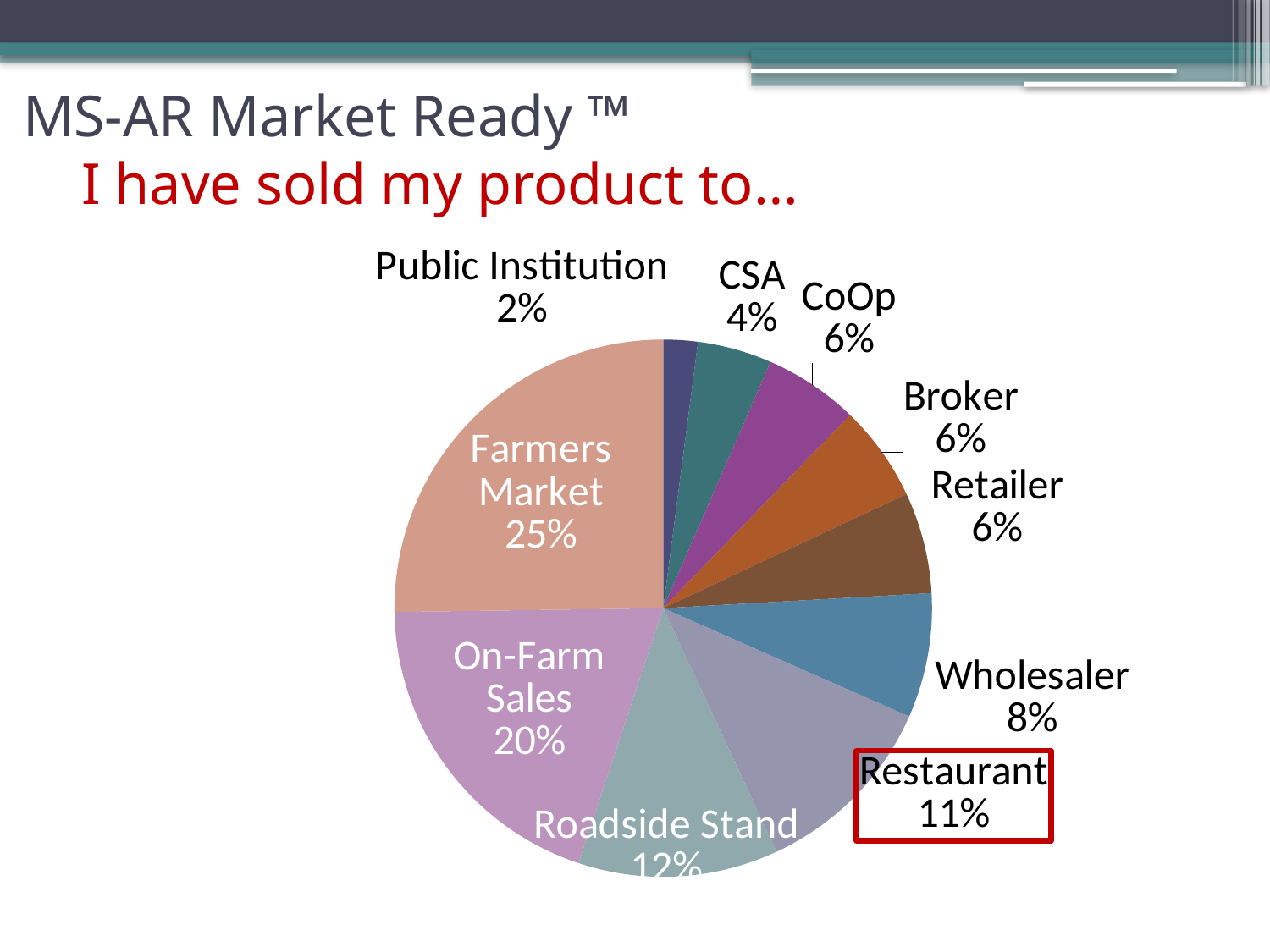
How many categories are shown in the pie chart? 10 What kind of chart is shown on the slide? pie chart What share of the pie does Restaurant have? 11% Which category's label is outlined with a red box on the slide? Restaurant What percentage of the pie is Farmers Market? 25% Which category has the largest slice of the pie? Farmers Market What is the value shown for On-Farm Sales? 20% What is the value shown for Wholesaler? 8% What is the difference in percentage points between Farmers Market and On-Farm Sales? 5 What percentage is shown for Public Institution? 2% Which category has the smallest slice of the pie? Public Institution Which is larger, the share for Restaurant or the share for Wholesaler? Restaurant